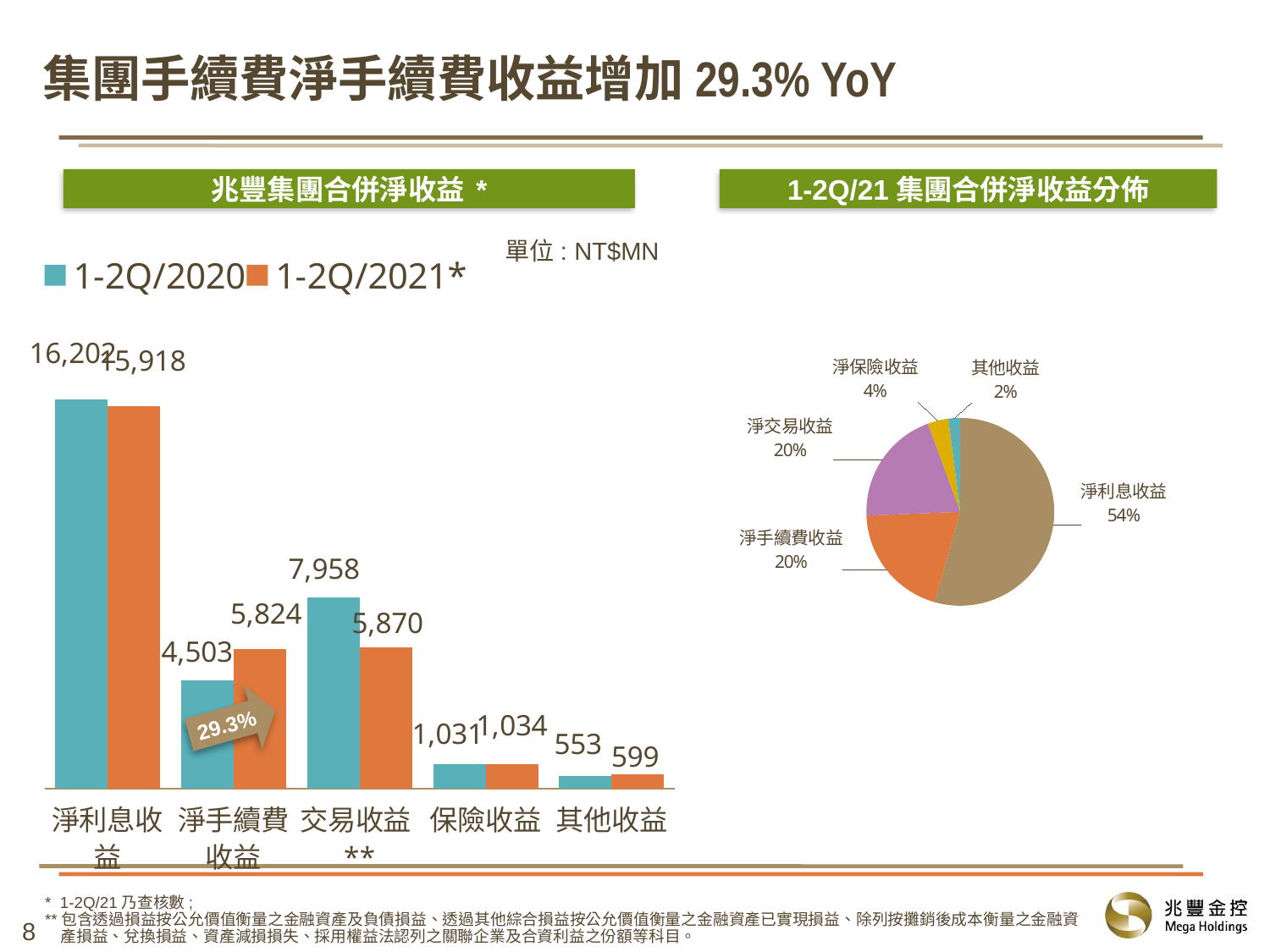
In the pie chart 1-2Q/21 集團合併淨收益分佈, what share does 淨利息收益 have? 54% In the bar chart 兆豐集團合併淨收益, which category has the highest 1-2Q/2021* value? 淨利息收益 In the bar chart 兆豐集團合併淨收益, what is the 1-2Q/2021* value for 淨手續費收益? 5,824 What kind of chart is the chart on the right of the slide, titled 1-2Q/21 集團合併淨收益分佈? Pie chart In the pie chart 1-2Q/21 集團合併淨收益分佈, which slice is the smallest? 其他收益 In the bar chart 兆豐集團合併淨收益, what is the difference between the 1-2Q/2021* and 1-2Q/2020 values for 淨手續費收益? 1,321 In the bar chart 兆豐集團合併淨收益, what is the 1-2Q/2021* value for 其他收益? 599 In the bar chart 兆豐集團合併淨收益, is the 1-2Q/2020 or the 1-2Q/2021* value larger for 交易收益**? 1-2Q/2020 How many series does the legend of the bar chart 兆豐集團合併淨收益 list? 2 How many categories are shown on the x axis of the bar chart 兆豐集團合併淨收益? 5 In the bar chart 兆豐集團合併淨收益, which category has the lowest 1-2Q/2020 value? 其他收益 In the bar chart 兆豐集團合併淨收益, what is the 1-2Q/2020 value for 交易收益**? 7,958